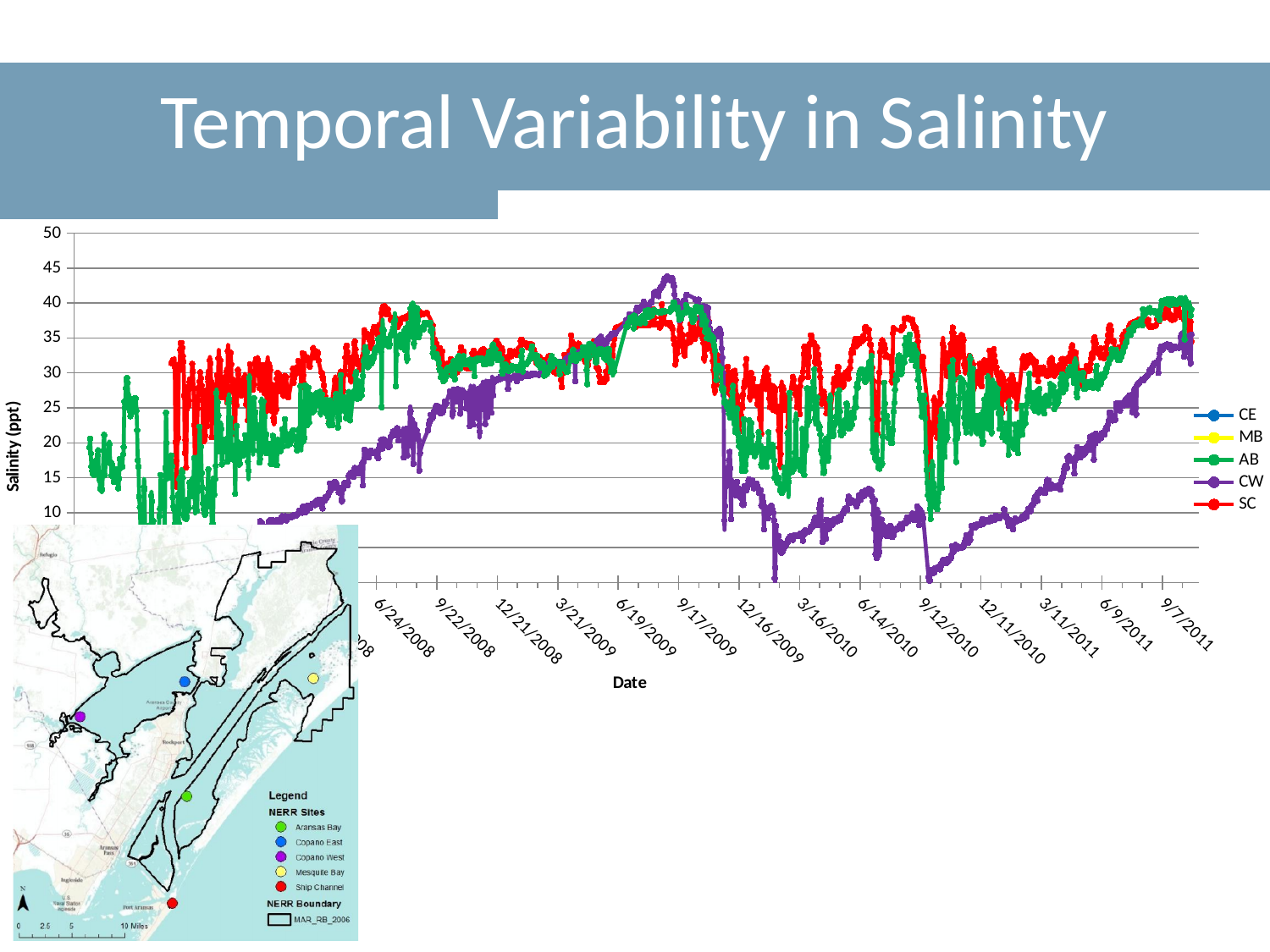
Is the peak value of the CW series around 9/17/2009 greater or less than 40? greater Does the CW series rise or fall between 3/11/2011 and 9/7/2011? rise What kind of chart is shown on the slide? line chart What is the label on the vertical axis of the chart? Salinity (ppt) Around 3/16/2010, which series has higher values, SC or CW? SC Which series has the lowest values around 3/16/2010? CW How many series does the chart's legend list? 5 Which series reaches the highest salinity value on the chart? CW Is the value of the SC series around 6/24/2008 greater or less than 30? greater Is the value of the CW series around 3/16/2010 greater or less than 15? less Does the CW series rise or fall between 9/17/2009 and 12/16/2009? fall